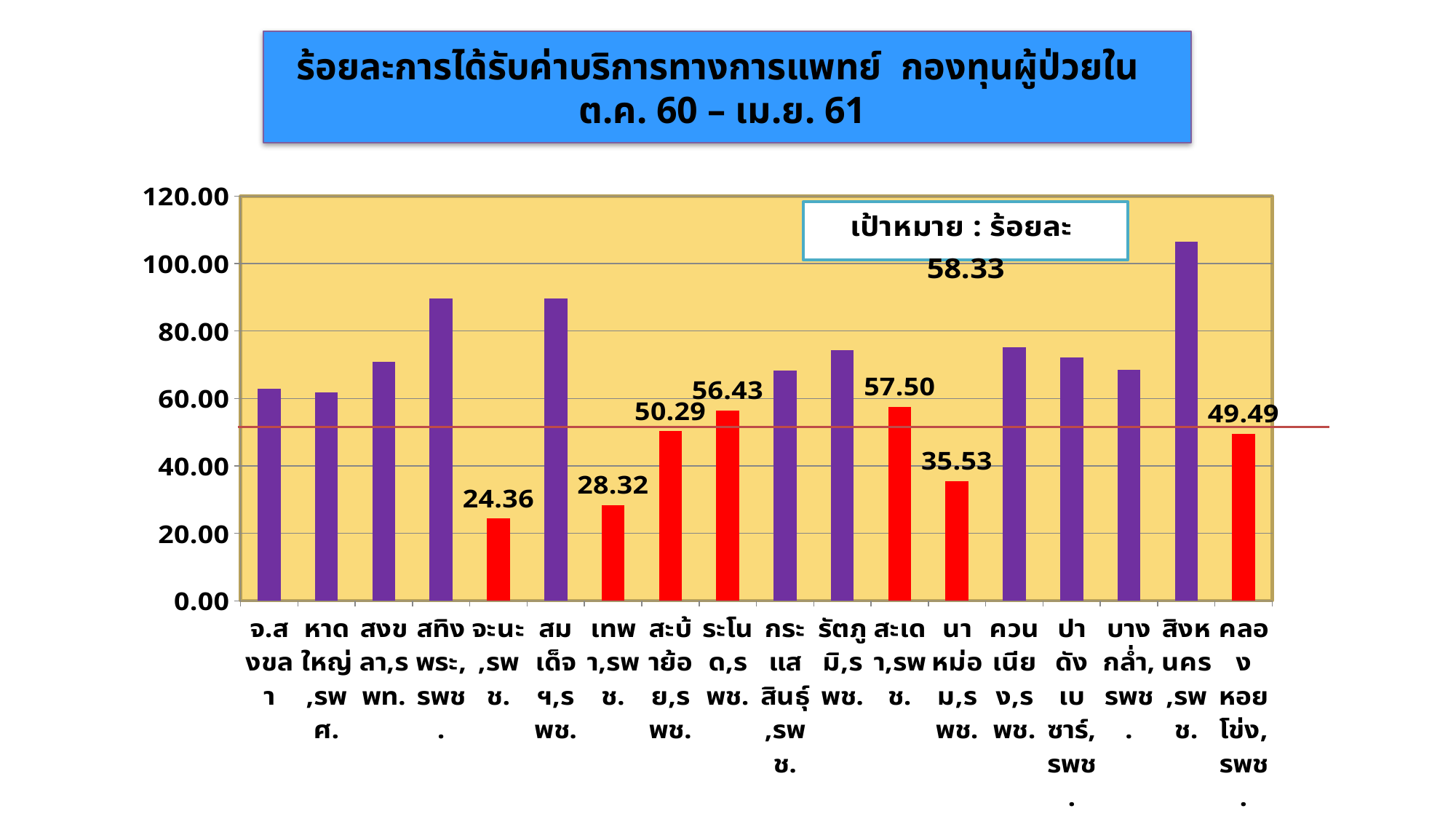
What kind of chart is shown on the slide? bar chart Which is larger, the value for ระโนด,รพช. or the value for สะบ้าย้อย,รพช.? ระโนด,รพช. What is the value shown for จะนะ,รพช.? 24.36 Which category has the lowest value? จะนะ,รพช. What is the value shown for สะเดา,รพช.? 57.50 What is the value shown for คลองหอยโข่ง,รพช.? 49.49 Which category has the highest value? สิงหนคร,รพช. Is the value for สทิงพระ,รพช. greater or less than 80.00? greater How many categories are shown on the x axis? 18 What is the value shown for เทพา,รพช.? 28.32 What is the difference between the values for สะเดา,รพช. and นาหม่อม,รพช.? 21.97 Is the value for สิงหนคร,รพช. greater or less than 100.00? greater